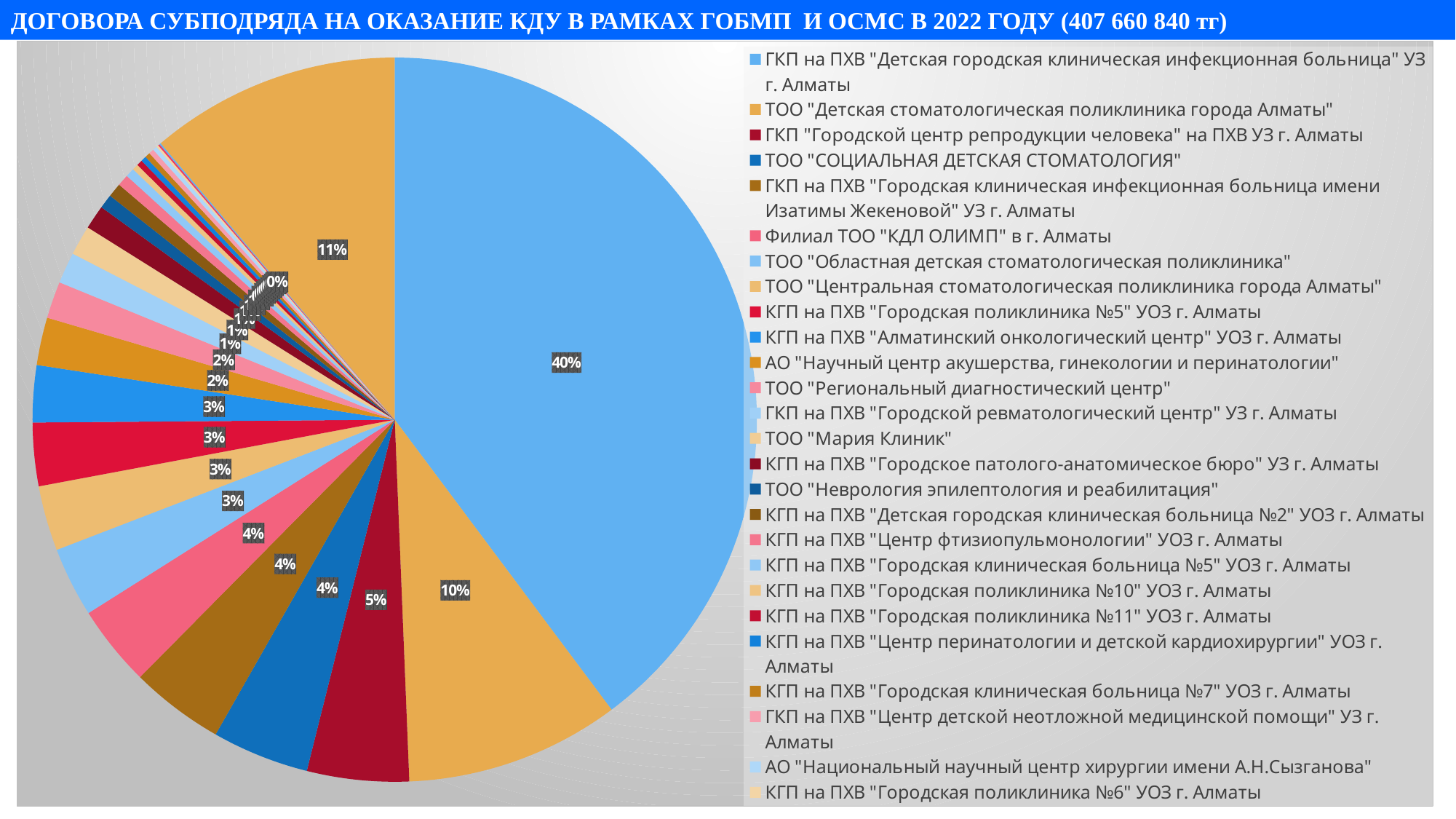
Is the share of the largest slice greater or less than 50%? less What is the combined share of the two largest slices (40% and 10%)? 50% What type of chart is shown on the slide? Pie chart By how many percentage points does the share of ГКП на ПХВ "Детская городская клиническая инфекционная больница" exceed that of ТОО "Детская стоматологическая поликлиника города Алматы"? 30 percentage points Which has the larger share: ТОО "Детская стоматологическая поликлиника города Алматы" or ГКП "Городской центр репродукции человека"? ТОО "Детская стоматологическая поликлиника города Алматы" What share of the pie does Филиал ТОО "КДЛ ОЛИМП" в г. Алматы hold? 4% What share of the pie does ТОО "Детская стоматологическая поликлиника города Алматы" hold? 10% Which organisation has the largest share of the pie? ГКП на ПХВ "Детская городская клиническая инфекционная больница" УЗ г. Алматы What total amount in tenge is given in the chart title? 407 660 840 тг What share of the pie does ГКП "Городской центр репродукции человека" на ПХВ УЗ г. Алматы hold? 5%